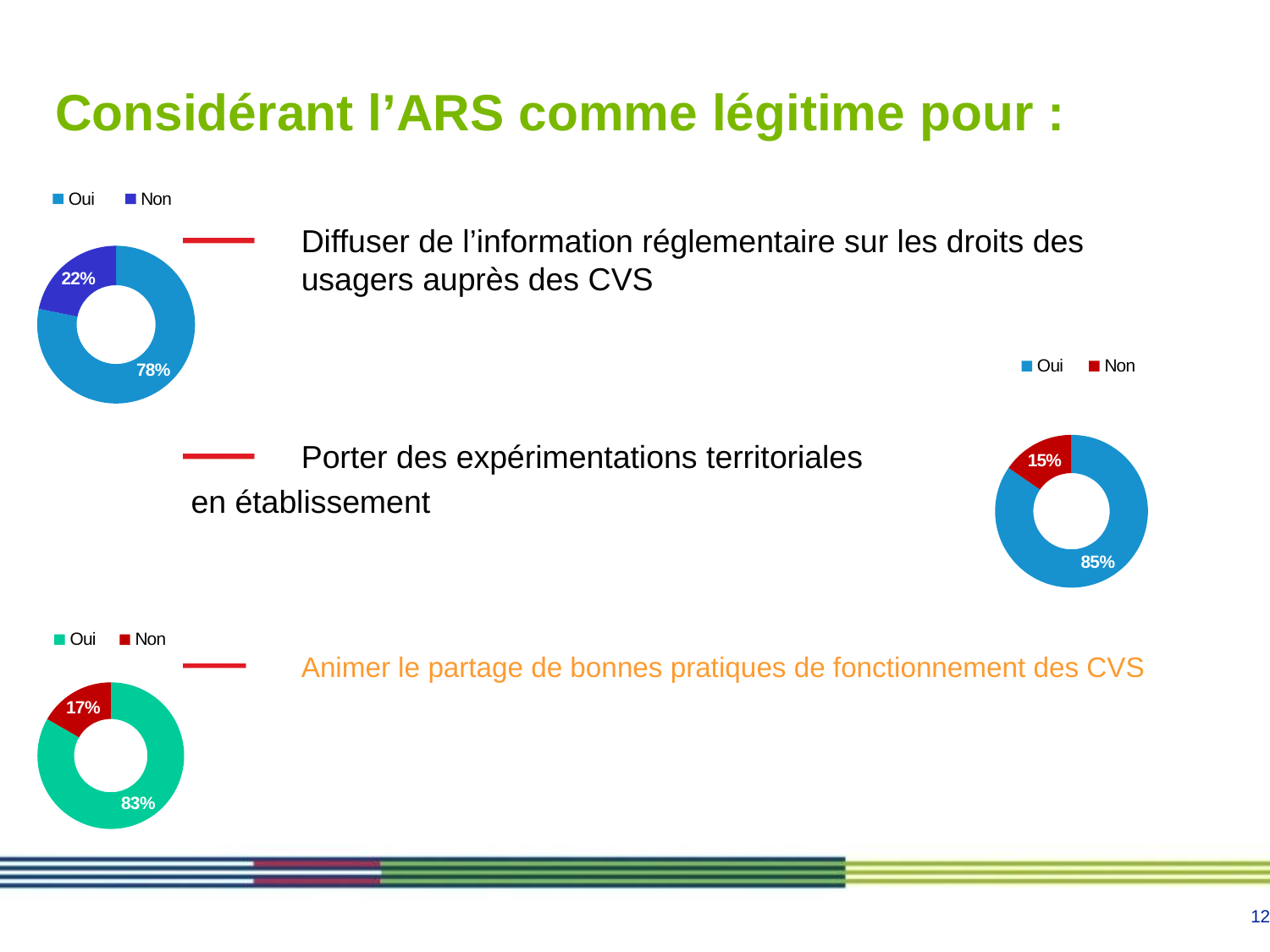
In the bottom-left donut chart, which category has the smallest slice? Non In the middle-right donut chart (Porter des expérimentations territoriales), what percentage answered Non? 15% What type of chart is used for the bottom-left chart? Donut (pie) chart In the top-left donut chart (Diffuser de l'information réglementaire), what percentage answered Oui? 78% How many slices does the middle-right donut chart have? 2 In the top-left donut chart (Diffuser de l'information réglementaire), what percentage answered Non? 22% In the bottom-left donut chart (Animer le partage de bonnes pratiques), what percentage answered Oui? 83% In the middle-right donut chart, which slice is larger, Oui or Non? Oui How many series does the legend of the top-left chart list? 2 In the middle-right donut chart (Porter des expérimentations territoriales), what percentage answered Oui? 85% In the bottom-left donut chart (Animer le partage de bonnes pratiques), what percentage answered Non? 17% In the top-left donut chart, what is the difference between the Oui and Non shares? 56%